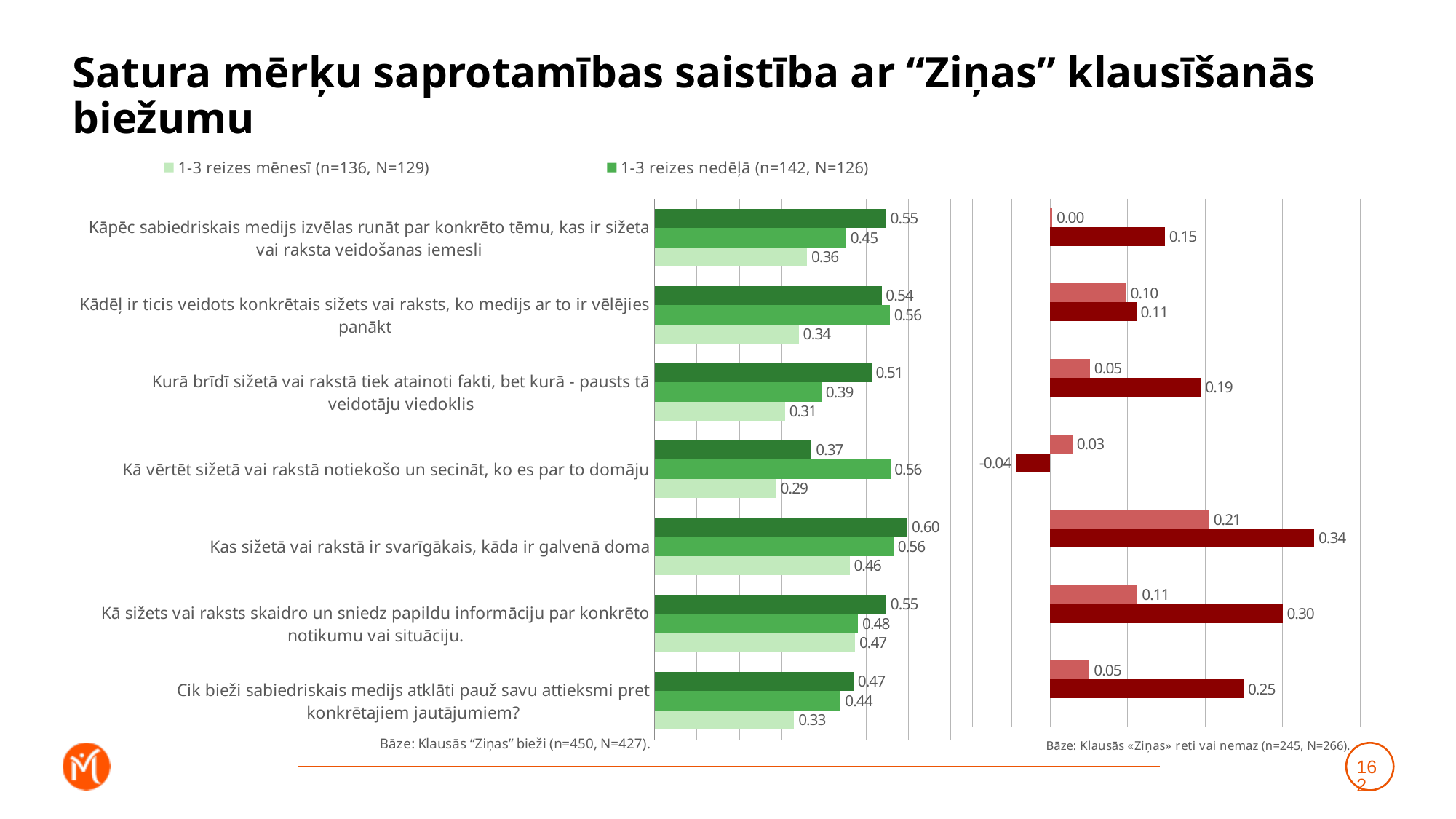
In the left chart, for 'Cik bieži sabiedriskais medijs atklāti pauž savu attieksmi pret konkrētajiem jautājumiem?', which series is larger: '1-3 reizes nedēļā' or '1-3 reizes mēnesī'? 1-3 reizes nedēļā What type of chart is shown on the left side of the slide? bar chart What base is stated below the right chart? Bāze: Klausās «Ziņas» reti vai nemaz (n=245, N=266). How many categories are shown in the left chart? 7 In the left chart, what is the value of the '1-3 reizes mēnesī' series for 'Kas sižetā vai rakstā ir svarīgākais, kāda ir galvenā doma'? 0.46 In the left chart, what is the difference between the '1-3 reizes nedēļā' and '1-3 reizes mēnesī' values for 'Kādēļ ir ticis veidots konkrētais sižets vai raksts, ko medijs ar to ir vēlējies panākt'? 0.22 How many series does the legend at the top of the slide list? 2 In the left chart, which category has the lowest value for the '1-3 reizes mēnesī' series? Kā vērtēt sižetā vai rakstā notiekošo un secināt, ko es par to domāju In the right chart, what is the value of the light red bar for 'Kāpēc sabiedriskais medijs izvēlas runāt par konkrēto tēmu, kas ir sižeta vai raksta veidošanas iemesli'? 0.00 In the left chart, what is the value of the '1-3 reizes nedēļā' series for 'Kā vērtēt sižetā vai rakstā notiekošo un secināt, ko es par to domāju'? 0.56 In the right chart, which category has a negative value for the dark red bar? Kā vērtēt sižetā vai rakstā notiekošo un secināt, ko es par to domāju In the right chart, what is the value of the dark red bar for 'Kas sižetā vai rakstā ir svarīgākais, kāda ir galvenā doma'? 0.34